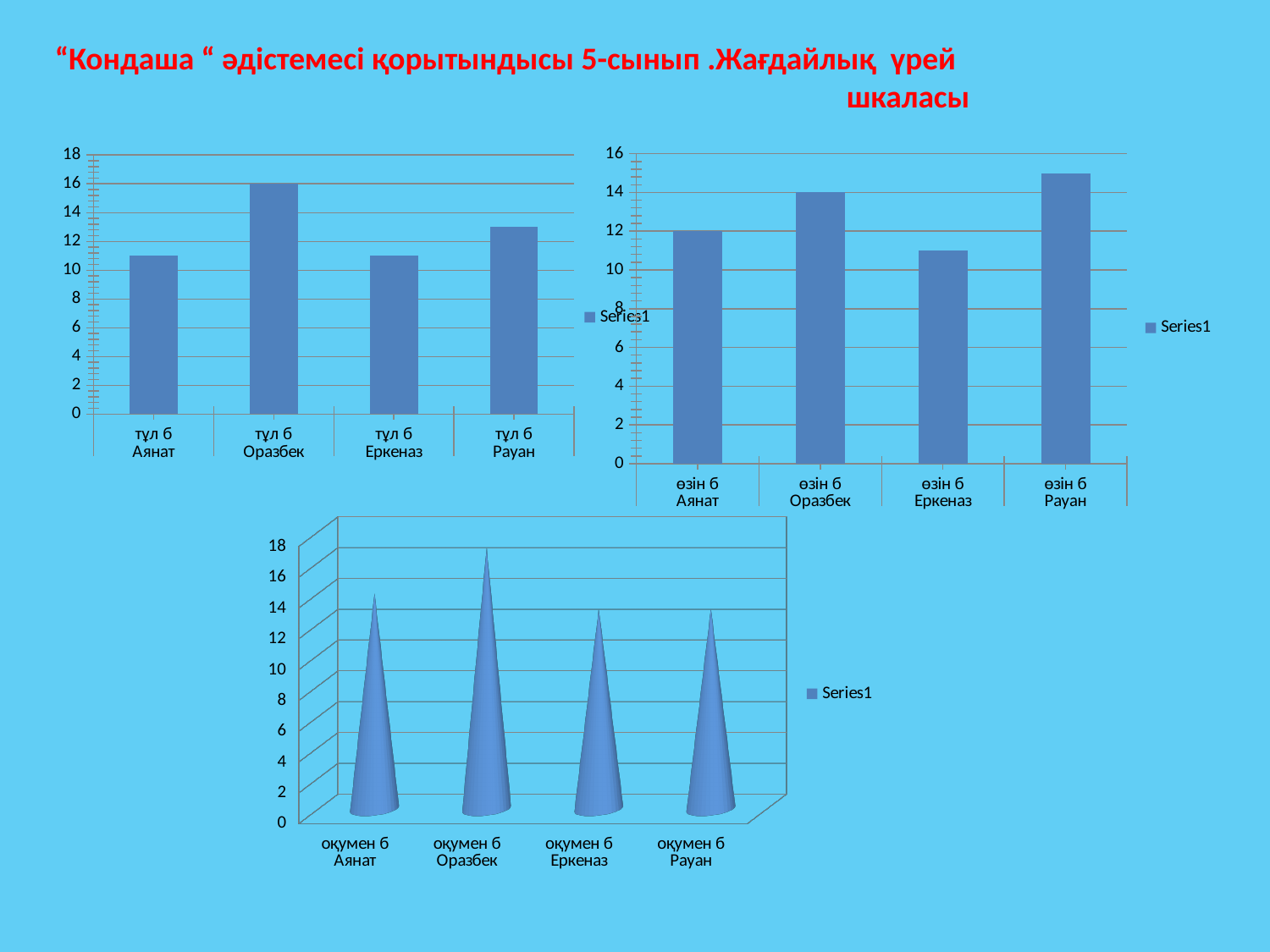
In the top-right chart, which is larger, the value for өзін б Аянат or the value for өзін б Рауан? өзін б Рауан In the top-left chart, is the value for тұл б Рауан greater or less than 12? greater In the top-right chart, is the value for өзін б Оразбек greater or less than 12? greater In the top-right chart, which category has the lowest bar? өзін б Еркеназ In the top-right chart, which category has the highest bar? өзін б Рауан In the top-left chart, is the value for тұл б Аянат greater or less than 12? less How many series does the legend of the top-right chart list? 1 In the bottom chart, which category has the highest value? оқумен б Оразбек What kind of chart is the top-left chart on the slide? bar chart In the top-left chart, which category has the highest bar? тұл б Оразбек How many categories does the top-left chart show? 4